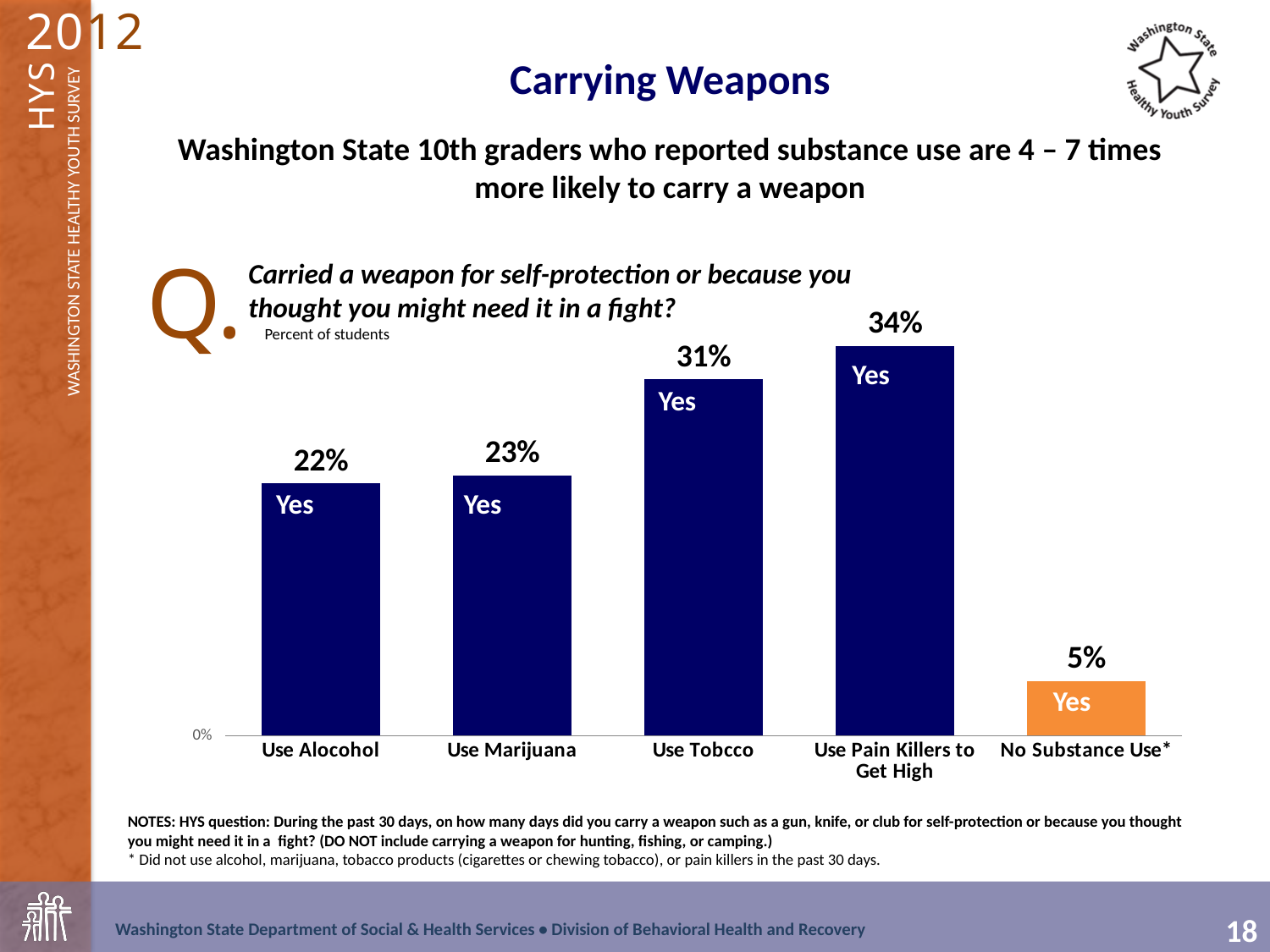
What is the value shown for the 'Use Tobcco' bar? 31% What kind of chart is shown on the slide? Bar chart What percentage of students who use alcohol reported carrying a weapon? 22% What is the difference between the 'Use Pain Killers to Get High' value and the 'No Substance Use*' value? 29% What percentage of students who use marijuana reported carrying a weapon? 23% What is the value shown for students who use pain killers to get high? 34% Which category has the lowest percentage of students carrying a weapon? No Substance Use* What is the value shown for the 'No Substance Use*' bar? 5% How many categories are shown on the x axis of the chart? 5 Which category has the highest percentage of students carrying a weapon? Use Pain Killers to Get High Which is larger: the value for 'Use Tobcco' or the value for 'Use Marijuana'? Use Tobcco Which bar is shown in orange rather than dark blue? No Substance Use*